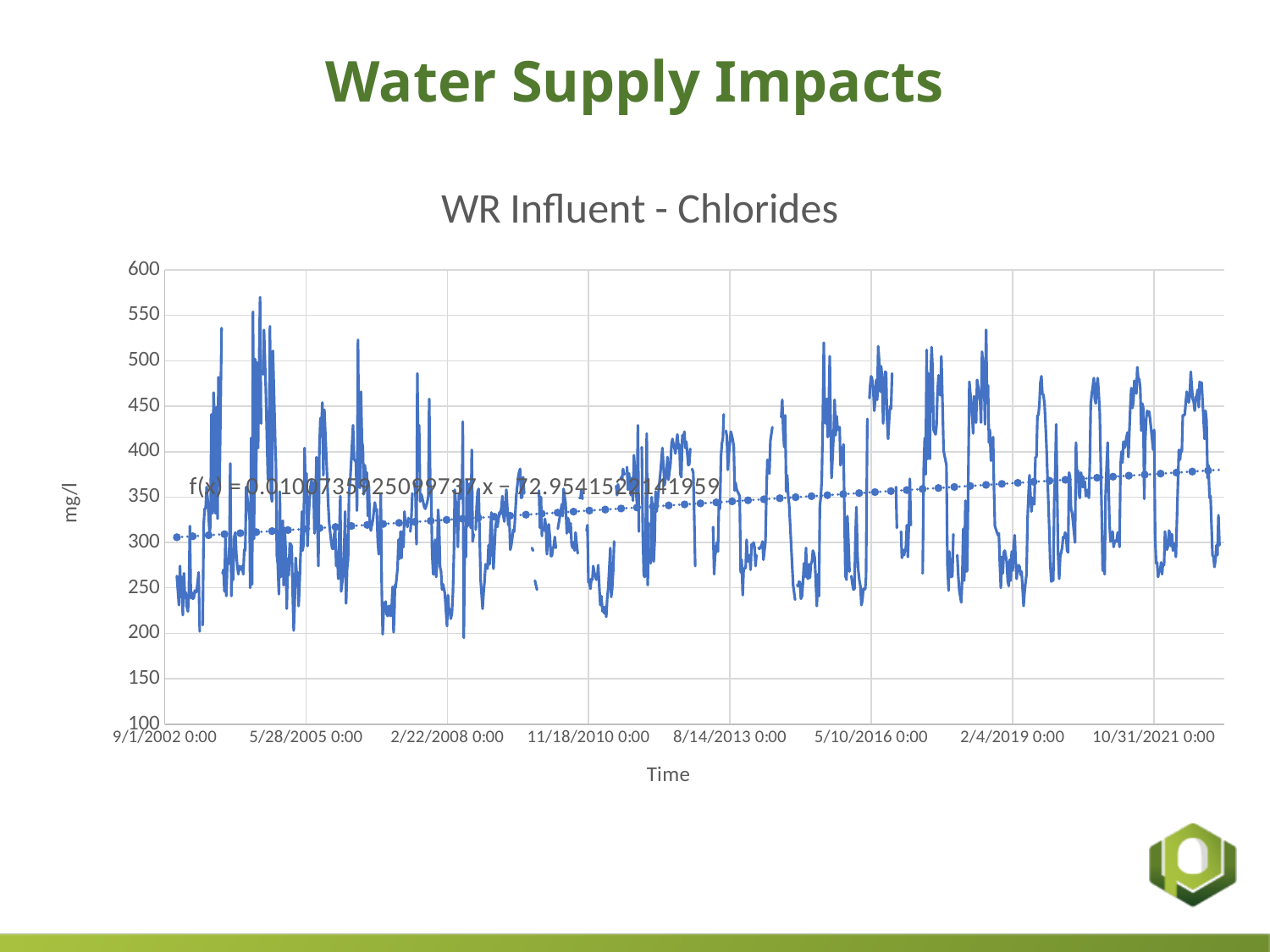
What is the first date label on the horizontal axis? 9/1/2002 0:00 How many date labels are shown on the horizontal axis? 8 What is the lowest value shown on the vertical axis? 100 What is the title of the chart? WR Influent - Chlorides Is the trendline value at the end of the series (late 2021) greater or less than 350 mg/l? greater What kind of chart is shown on the slide? line chart Is the trendline value at the start of the series (9/1/2002) greater or less than 350 mg/l? less Is the highest peak of the chloride series, near 2005, greater or less than 550 mg/l? greater What is the label on the vertical axis of the chart? mg/l According to the dotted trendline, do chloride values rise or fall over time? rise What is the highest value shown on the vertical axis? 600 What is the last date label on the horizontal axis? 10/31/2021 0:00